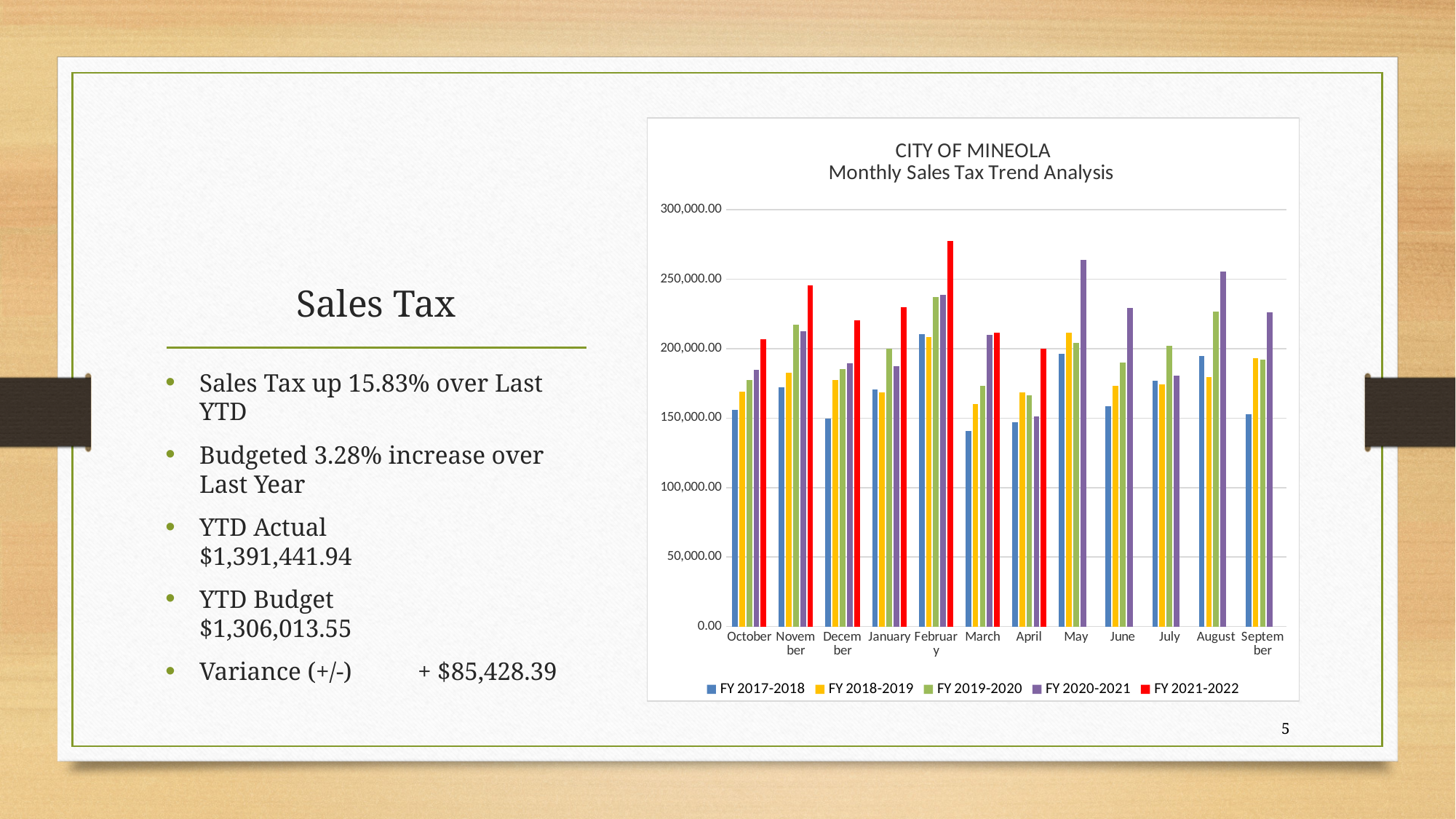
What type of chart is shown on the slide? Bar chart How many fiscal year series does the chart legend list? 5 Which fiscal year series is shown in red in the chart? FY 2021-2022 Is the FY 2017-2018 value for October greater or less than 200,000.00? less Which is larger for May: the FY 2020-2021 value or the FY 2017-2018 value? FY 2020-2021 Is the FY 2020-2021 value for May greater or less than 250,000.00? greater In which month is the FY 2021-2022 value the highest? February Is the FY 2017-2018 value for March greater or less than 150,000.00? less Which is larger for February: the FY 2021-2022 value or the FY 2020-2021 value? FY 2021-2022 For how many months does the chart show an FY 2021-2022 bar? 7 How many months are shown along the x axis of the chart? 12